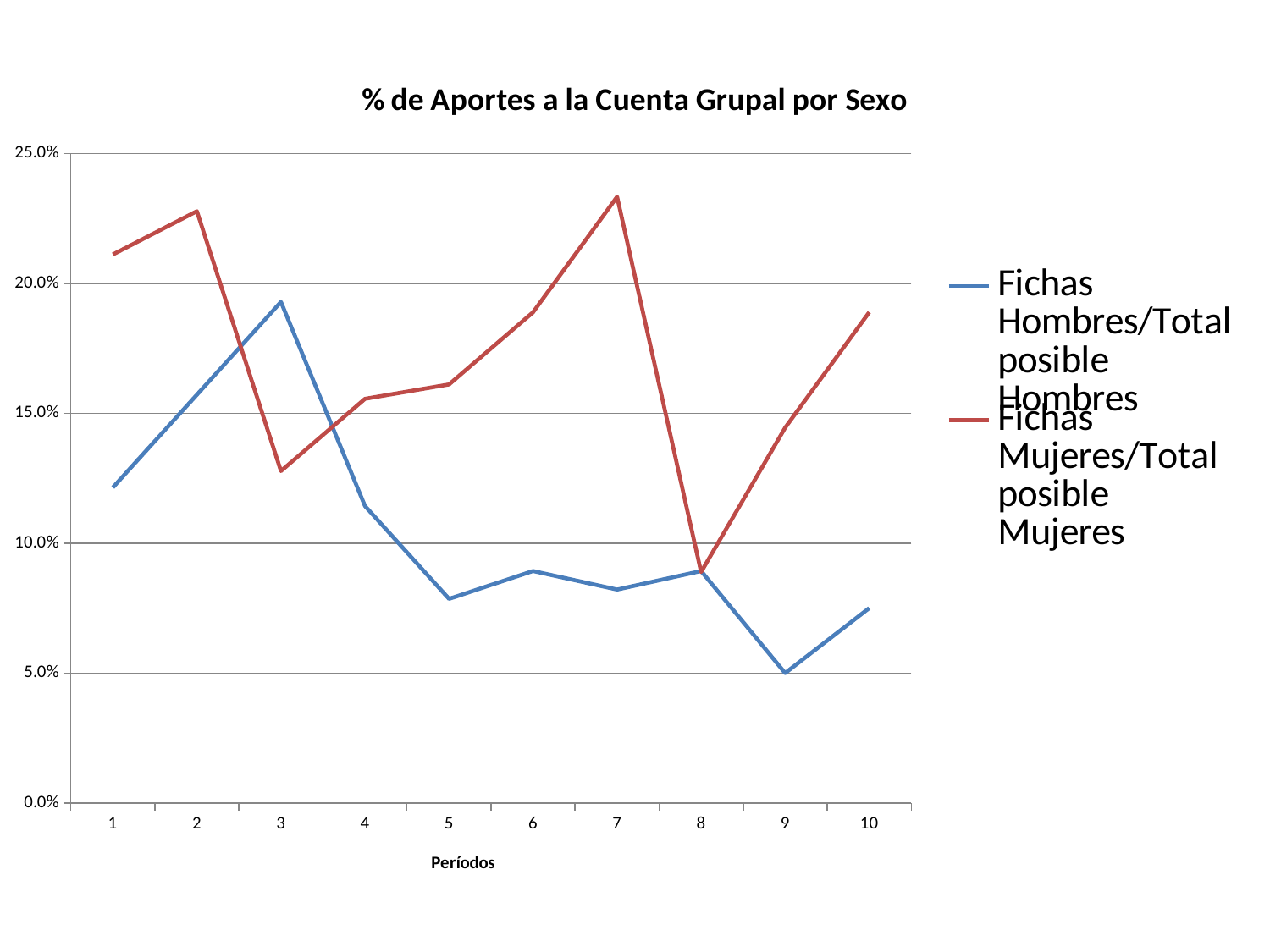
In period 1, which series has the higher value? Fichas Mujeres/Total posible Mujeres How many periods are plotted along the x axis? 10 Is the value for Fichas Hombres/Total posible Hombres in period 1 greater or less than 10.0%? greater Is the value for Fichas Mujeres/Total posible Mujeres in period 2 greater or less than 20.0%? greater In which period does the Fichas Mujeres/Total posible Mujeres series reach its highest value? 7 What is the title of the chart? % de Aportes a la Cuenta Grupal por Sexo What kind of chart is shown on the slide? line chart How many series does the legend list? 2 In which period does the Fichas Mujeres/Total posible Mujeres series reach its lowest value? 8 In which period does the Fichas Hombres/Total posible Hombres series reach its highest value? 3 In period 3, which series has the higher value? Fichas Hombres/Total posible Hombres In which period does the Fichas Hombres/Total posible Hombres series reach its lowest value? 9